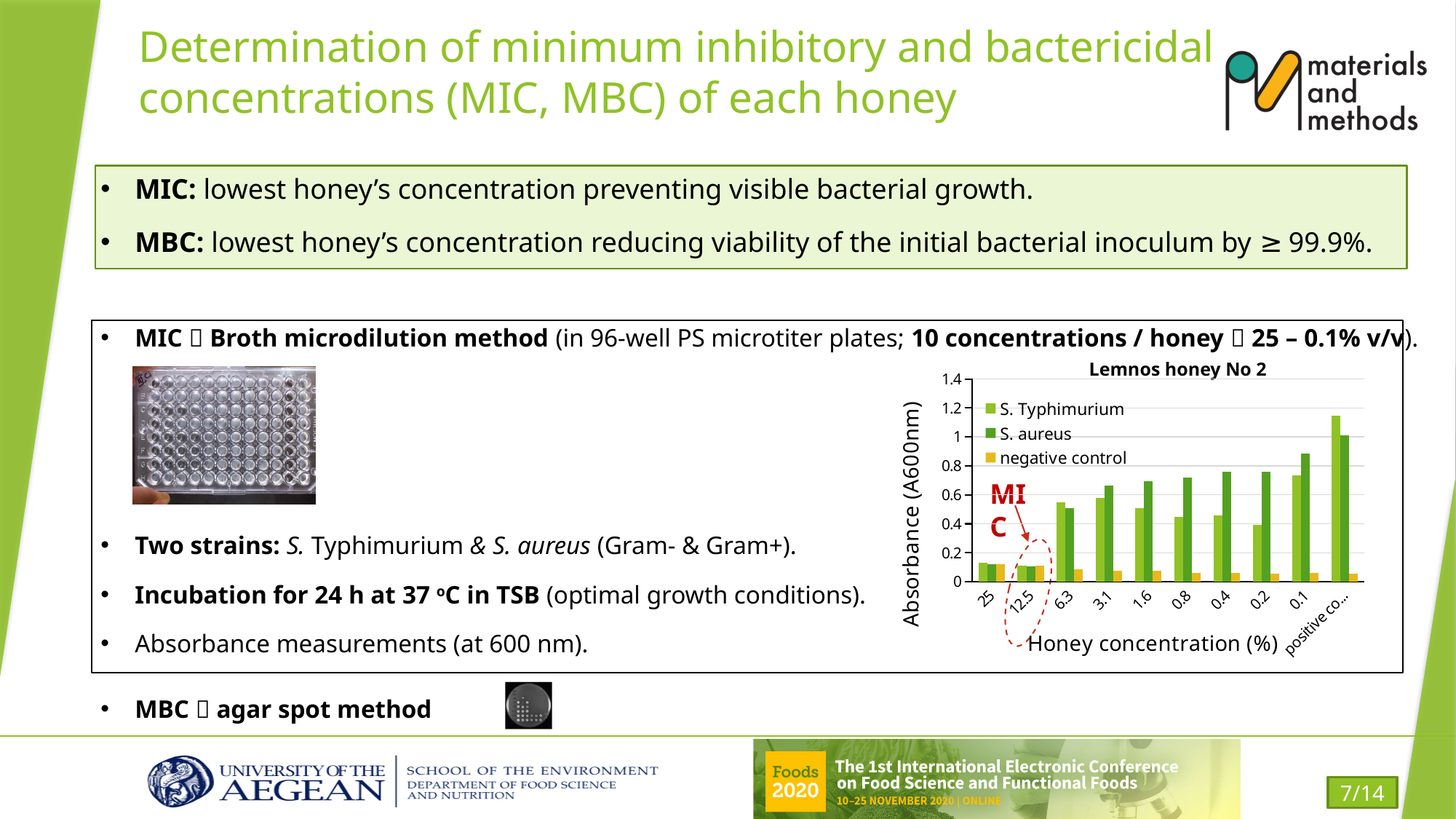
How many categories are shown on the x axis of the 'Lemnos honey No 2' chart? 10 In the 'Lemnos honey No 2' chart, which category has the highest S. Typhimurium absorbance? positive control What is the label of the y axis of the 'Lemnos honey No 2' chart? Absorbance (A600nm) How many series does the legend of the 'Lemnos honey No 2' chart list? 3 What kind of chart is shown under the title 'Lemnos honey No 2'? bar chart What is the label of the x axis of the 'Lemnos honey No 2' chart? Honey concentration (%) In the 'Lemnos honey No 2' chart, at 0.4% honey concentration, which series has the larger absorbance: S. Typhimurium or S. aureus? S. aureus In the 'Lemnos honey No 2' chart, does the S. aureus absorbance rise or fall going from 6.3% to 0.1% honey concentration? rise In the 'Lemnos honey No 2' chart, is the S. Typhimurium value at 6.3% honey concentration greater or less than 0.4? greater In the 'Lemnos honey No 2' chart, which category has the highest S. aureus absorbance? positive control In the 'Lemnos honey No 2' chart, is the S. aureus value at 0.1% honey concentration greater or less than 0.8? greater In the 'Lemnos honey No 2' chart, is the S. aureus value at 25% honey concentration greater or less than 0.2? less